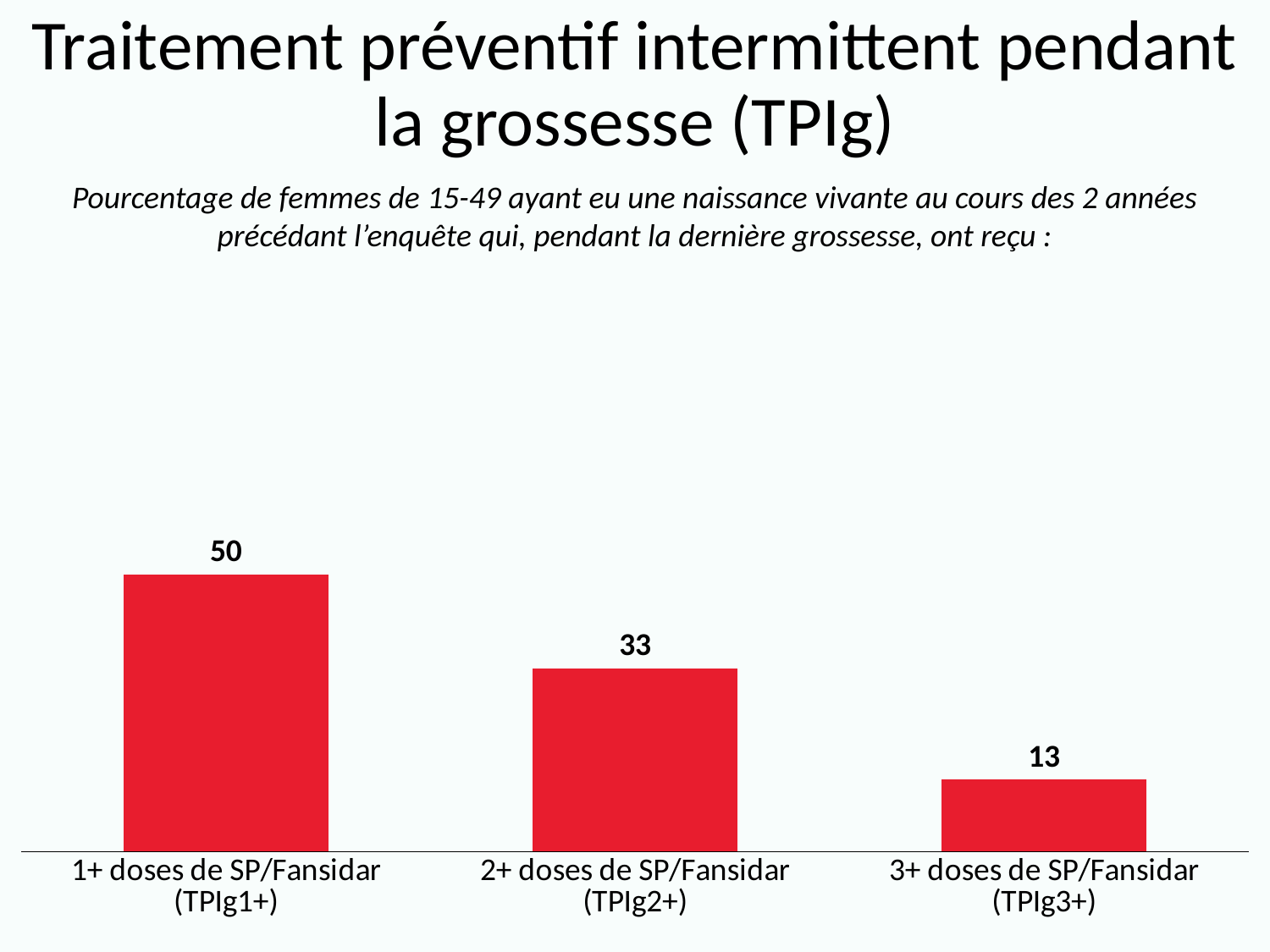
What is the difference between the values for TPIg2+ and TPIg3+? 20 Do the values rise or fall from left to right across the categories? Fall What kind of chart is shown on the slide? Bar chart How many categories are shown in the chart? 3 What is the value for 1+ doses de SP/Fansidar (TPIg1+)? 50 Which category has the highest value? 1+ doses de SP/Fansidar (TPIg1+) Which category has the lowest value? 3+ doses de SP/Fansidar (TPIg3+) What colour are the bars in the chart? Red What is the difference between the values for TPIg1+ and TPIg2+? 17 Which is larger, the value for TPIg2+ or the value for TPIg3+? TPIg2+ What is the value for 3+ doses de SP/Fansidar (TPIg3+)? 13 What is the value for 2+ doses de SP/Fansidar (TPIg2+)? 33